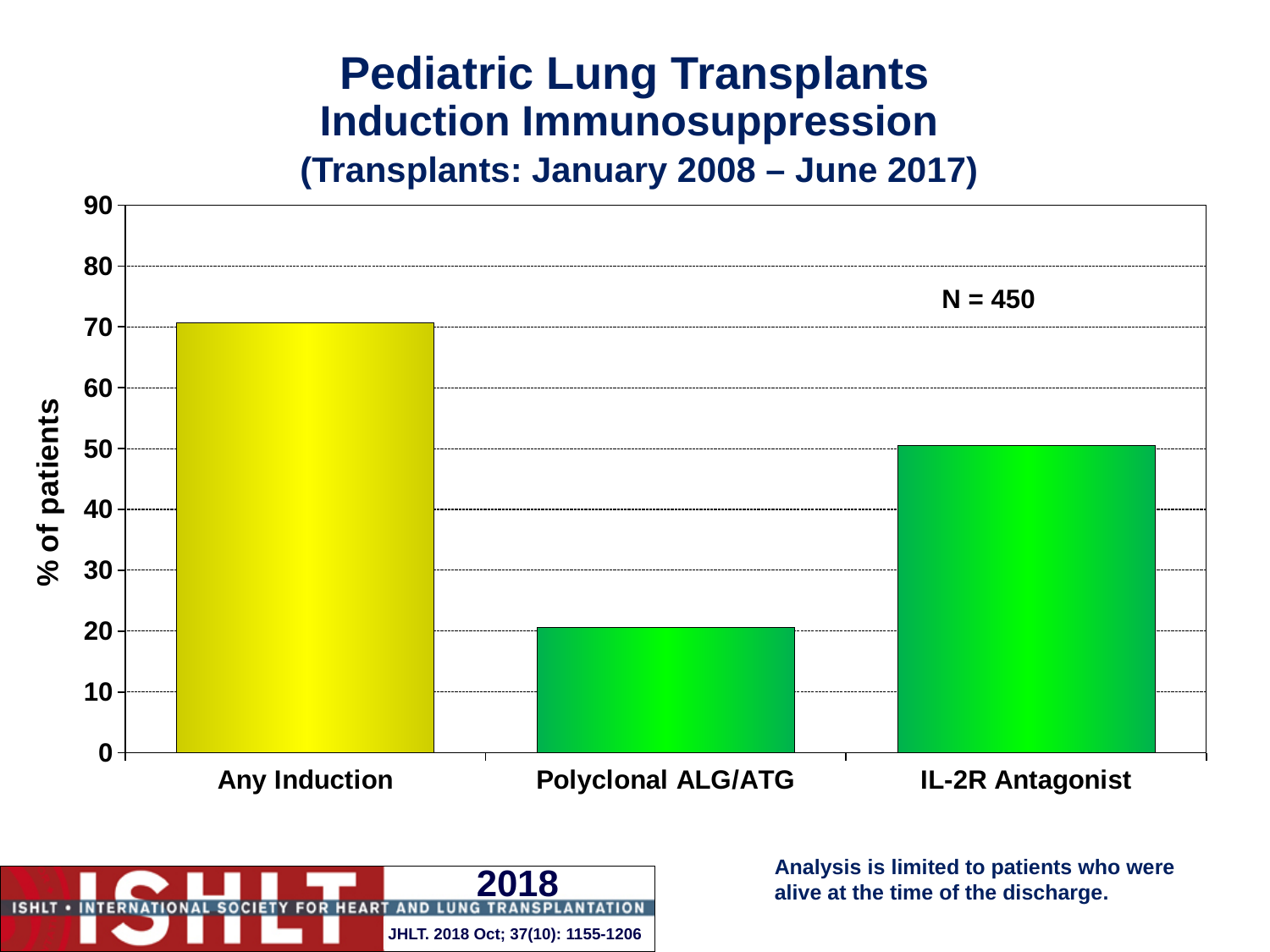
Which category has the lowest percentage of patients? Polyclonal ALG/ATG What is the label of the y axis? % of patients Is the value for IL-2R Antagonist greater or less than 40? greater What is the N value shown on the chart? N = 450 Which is larger, the value for IL-2R Antagonist or the value for Polyclonal ALG/ATG? IL-2R Antagonist Is the value for Any Induction greater or less than 60? greater Is the value for Polyclonal ALG/ATG greater or less than 30? less What kind of chart is shown on the slide? bar chart Which category has the highest percentage of patients? Any Induction Which is larger, the value for Any Induction or the value for IL-2R Antagonist? Any Induction How many categories are plotted on the x axis? 3